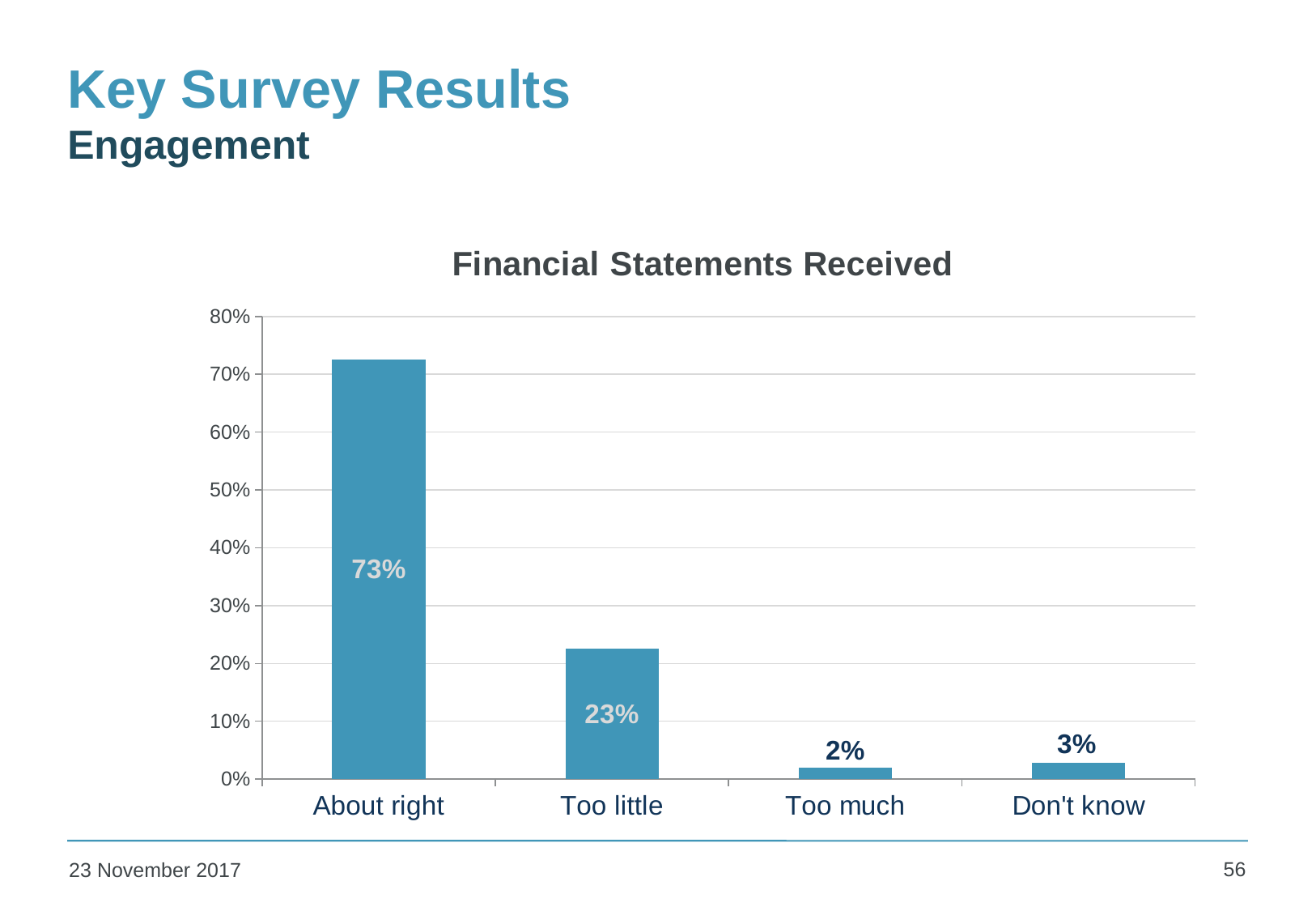
What is the value for "Don't know"? 3% What is the title of the chart? Financial Statements Received Which category has the lowest value? Too much What is the value for "Too little"? 23% How many categories are shown on the x axis? 4 Is the value for "About right" greater or less than 70%? greater What is the value for "Too much"? 2% What is the difference between the values for "About right" and "Too little"? 50% What kind of chart is shown on the slide? Bar chart Which is larger, the value for "Too little" or the value for "Don't know"? Too little What is the value for "About right"? 73% Which category has the highest value? About right